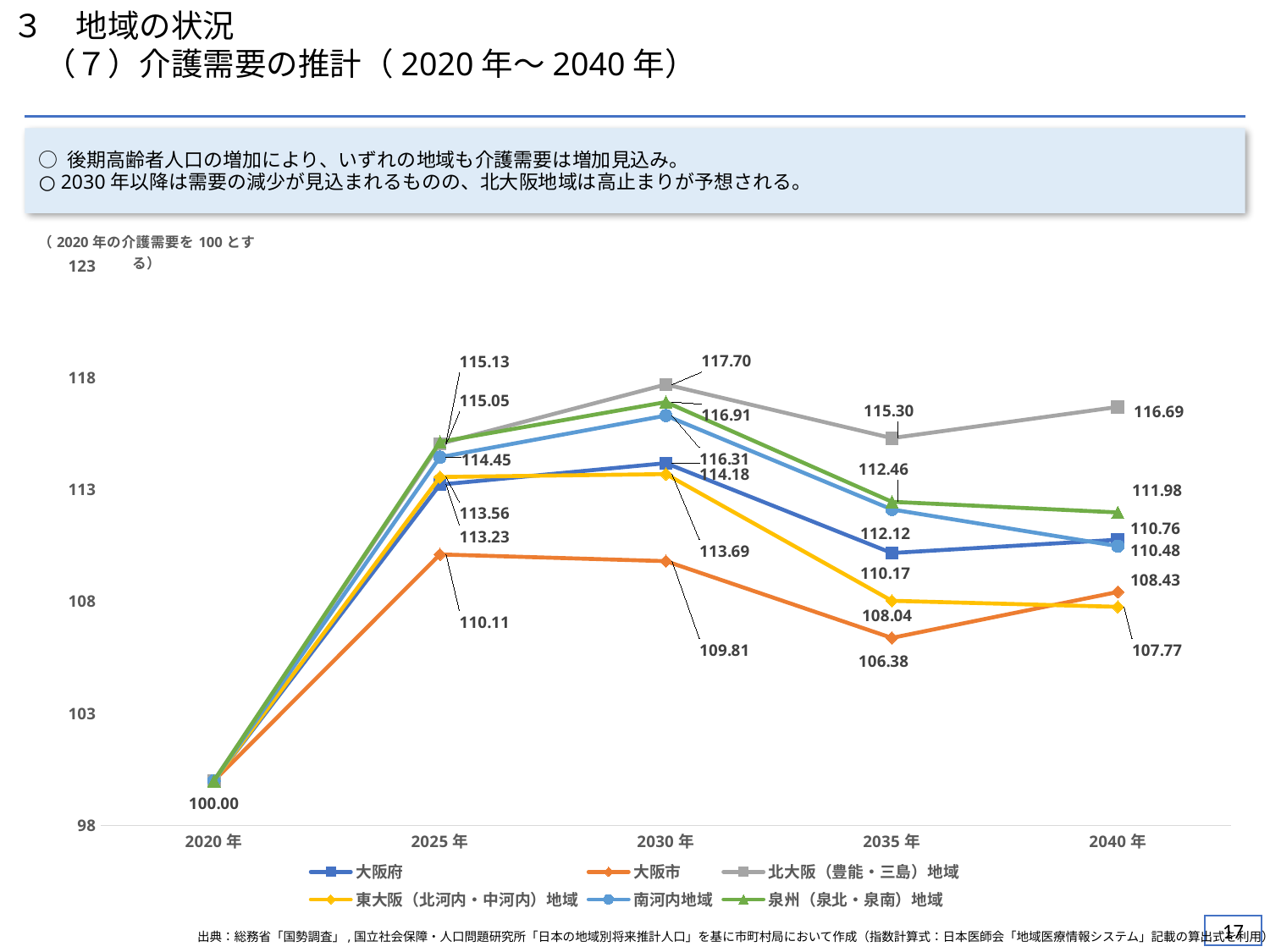
In 2040年, which is larger: 北大阪（豊能・三島）地域 or 大阪市? 北大阪（豊能・三島）地域 What is the value for 大阪市 in 2035年? 106.38 What value do all series share in 2020年? 100.00 What is the value for 北大阪（豊能・三島）地域 in 2030年? 117.70 Which series has the lowest value in 2035年? 大阪市 Is the value for 大阪市 in 2035年 greater or less than 108? less What kind of chart is shown on the slide? line chart How many series does the legend list? 6 What is the value for 北大阪（豊能・三島）地域 in 2040年? 116.69 Which series has the highest value in 2030年? 北大阪（豊能・三島）地域 How many years are shown on the x axis? 5 What is the difference between the 北大阪（豊能・三島）地域 values in 2030年 and 2035年? 2.40